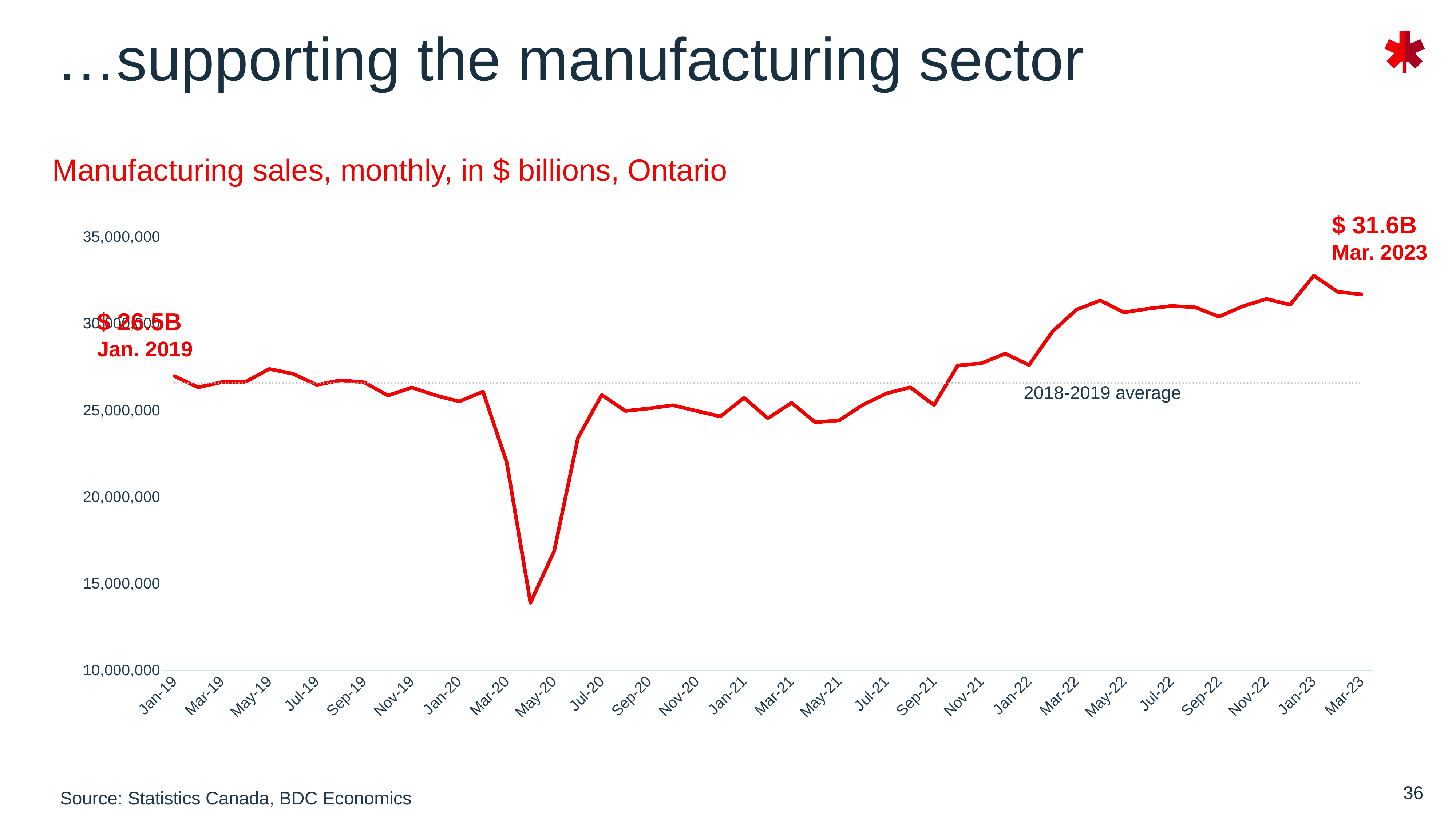
Is the lowest point of the line, in spring 2020, greater or less than 15,000,000? less What does the dotted horizontal line on the chart represent? 2018-2019 average Is the value for Nov-21 greater or less than 25,000,000? greater Is the value for Jan-23 greater or less than 30,000,000? greater Overall, do manufacturing sales rise or fall between Jan-19 and Mar-23? rise By how much did the labelled value in Mar. 2023 exceed the labelled value in Jan. 2019? $ 5.1B What is the title of the chart? Manufacturing sales, monthly, in $ billions, Ontario What was the value of Ontario manufacturing sales in Jan. 2019, according to the data label? $ 26.5B Which labelled point is larger: Jan. 2019 or Mar. 2023? Mar. 2023 What type of chart is shown on the slide? line chart What was the value of Ontario manufacturing sales in Mar. 2023, according to the data label? $ 31.6B